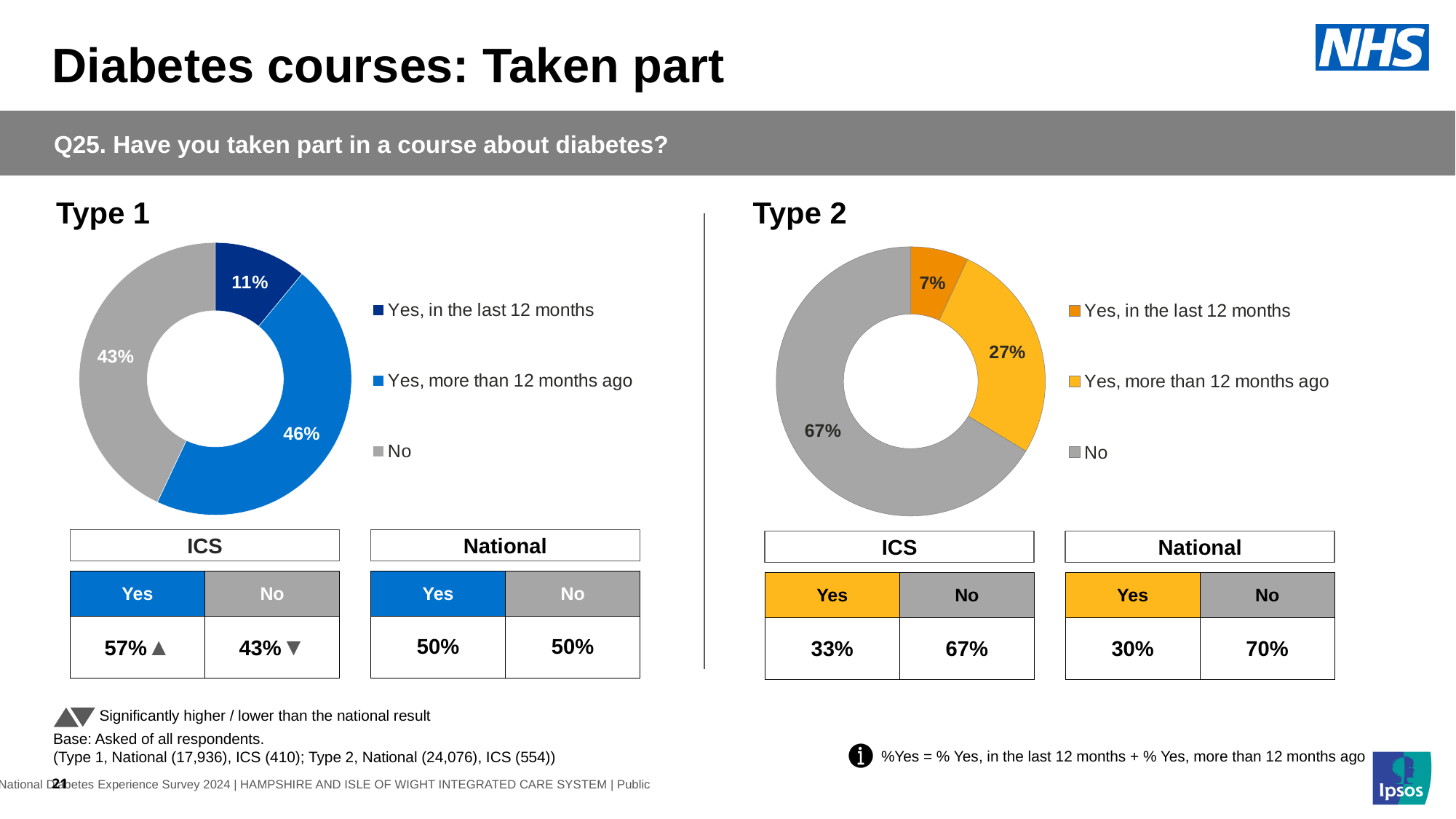
What kind of chart is used for Type 1? Doughnut chart In the Type 2 chart, which category has the smallest share? Yes, in the last 12 months Which is larger in the Type 1 chart: 'No' or 'Yes, more than 12 months ago'? Yes, more than 12 months ago In the Type 2 chart, what percentage said 'Yes, more than 12 months ago'? 27% In the Type 1 chart, what percentage said 'Yes, more than 12 months ago'? 46% How many categories does the Type 2 chart's legend list? 3 In the Type 1 chart, what is the combined share of the two 'Yes' categories? 57% In the Type 1 chart, what percentage of respondents said 'Yes, in the last 12 months'? 11% In the Type 2 chart, what is the difference between the 'No' share and the 'Yes, more than 12 months ago' share? 40 percentage points In the Type 2 chart, what colour represents 'No'? Grey In the Type 2 chart, what percentage of respondents said 'No'? 67% In the Type 1 chart, which category has the largest share? Yes, more than 12 months ago